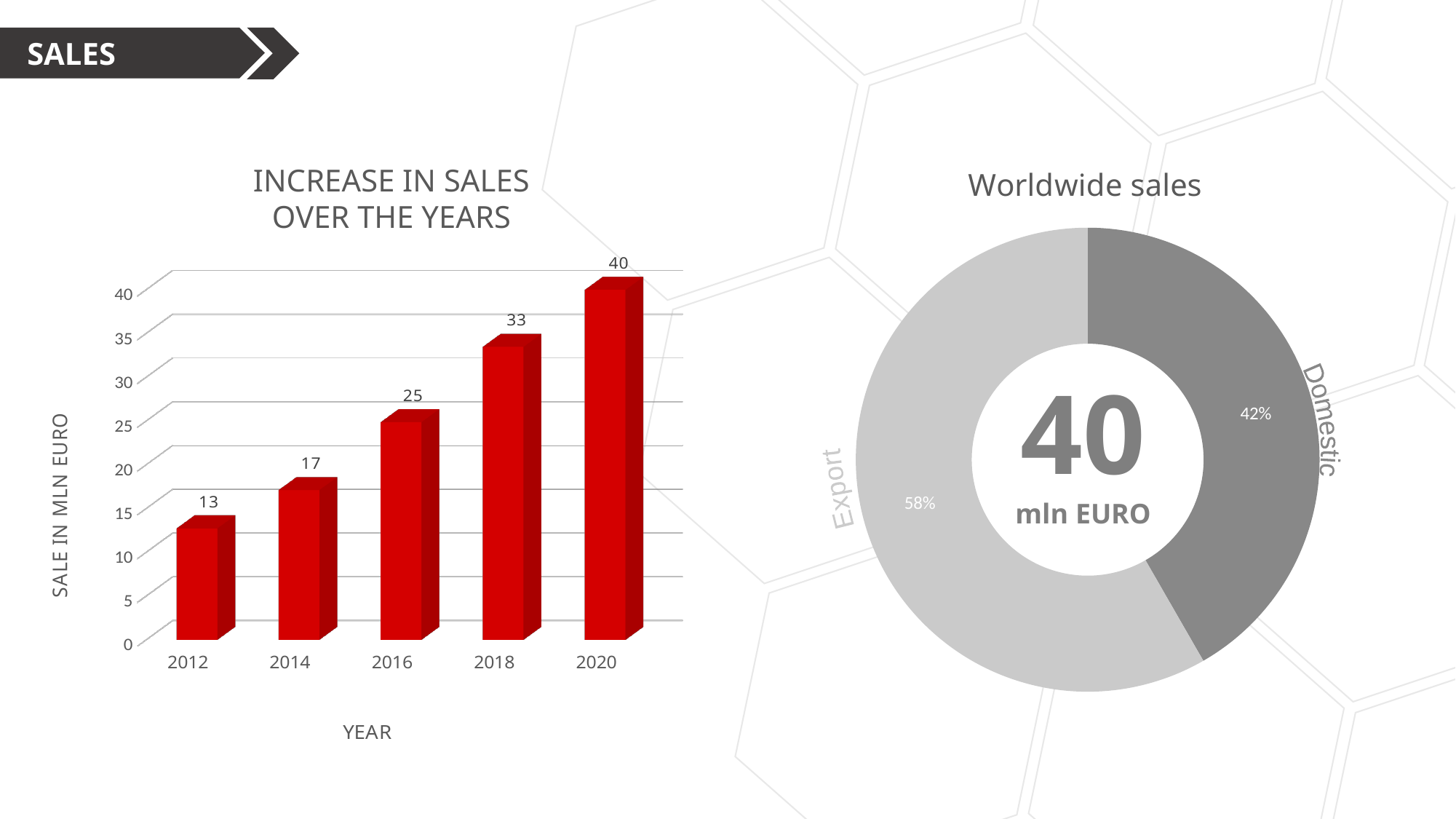
In the 'Increase in sales over the years' chart, which year has the lowest sales? 2012 In the 'Increase in sales over the years' chart, what is the difference between the sales in 2020 and 2018? 7 What kind of chart is 'Increase in sales over the years'? Bar chart In the 'Increase in sales over the years' chart, which year has higher sales, 2014 or 2016? 2016 In the 'Increase in sales over the years' chart, what is the sales value for 2016? 25 In the 'Increase in sales over the years' chart, do sales rise or fall from 2012 to 2020? Rise In the 'Increase in sales over the years' chart, how many years are shown on the x axis? 5 In the 'Increase in sales over the years' chart, which year has the highest sales? 2020 In the 'Worldwide sales' chart, what share of sales is Domestic? 42% What is the y-axis label of the 'Increase in sales over the years' chart? SALE IN MLN EURO In the 'Increase in sales over the years' chart, what is the sales value for 2012? 13 In the 'Worldwide sales' chart, what share of sales is Export? 58%